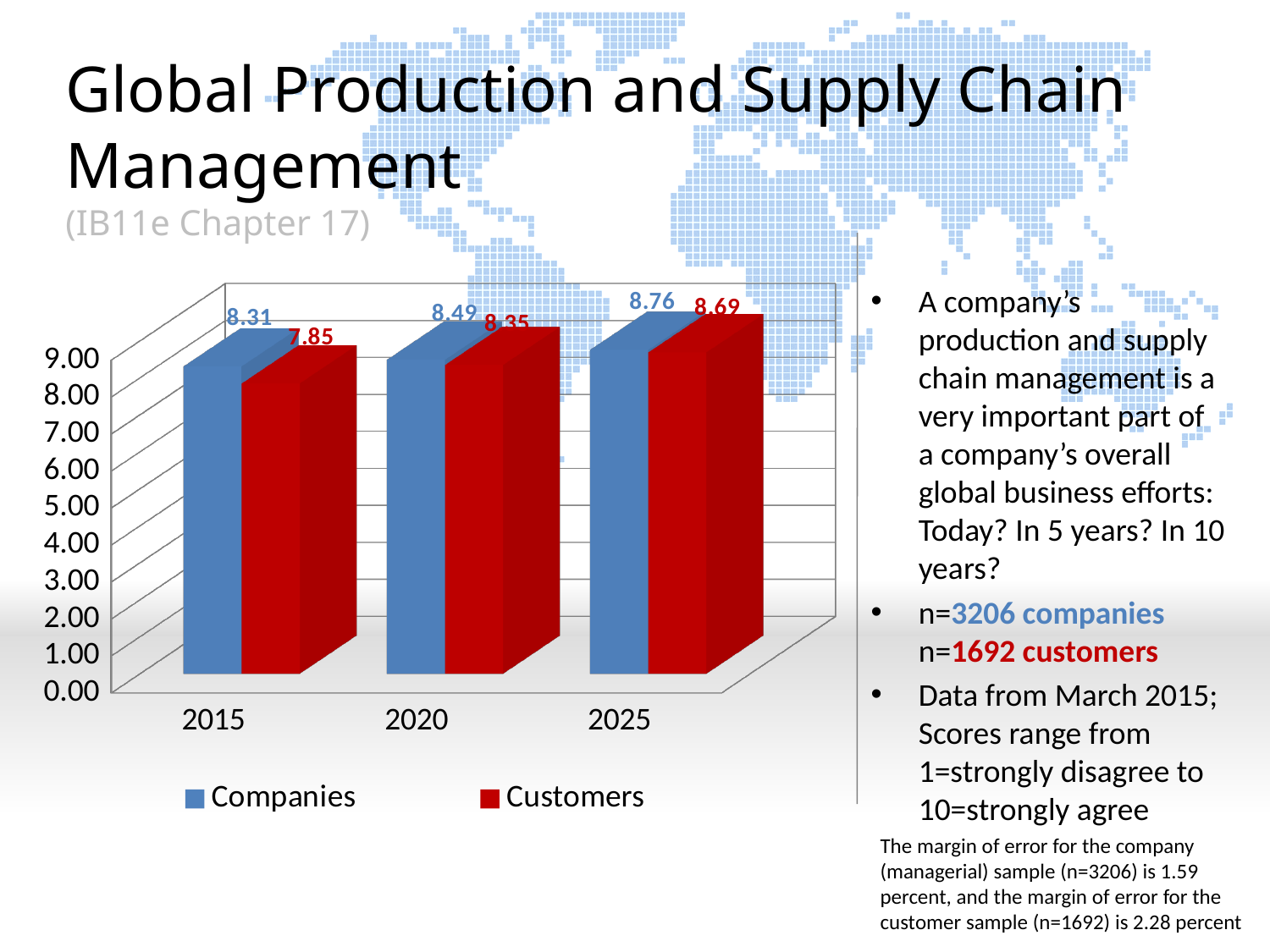
In which year is the Companies value highest? 2025 Do the Companies values rise or fall from 2015 to 2025? rise What is the value for Companies in 2020? 8.49 How many series does the legend list? 2 How many years are shown on the x axis? 3 What kind of chart is shown on the slide? bar chart What is the value for Customers in 2015? 7.85 What is the difference between the Companies and Customers values in 2015? 0.46 In which year is the Customers value lowest? 2015 What is the value for Customers in 2025? 8.69 Which is larger in 2025, the Companies value or the Customers value? Companies What is the value for Companies in 2015? 8.31